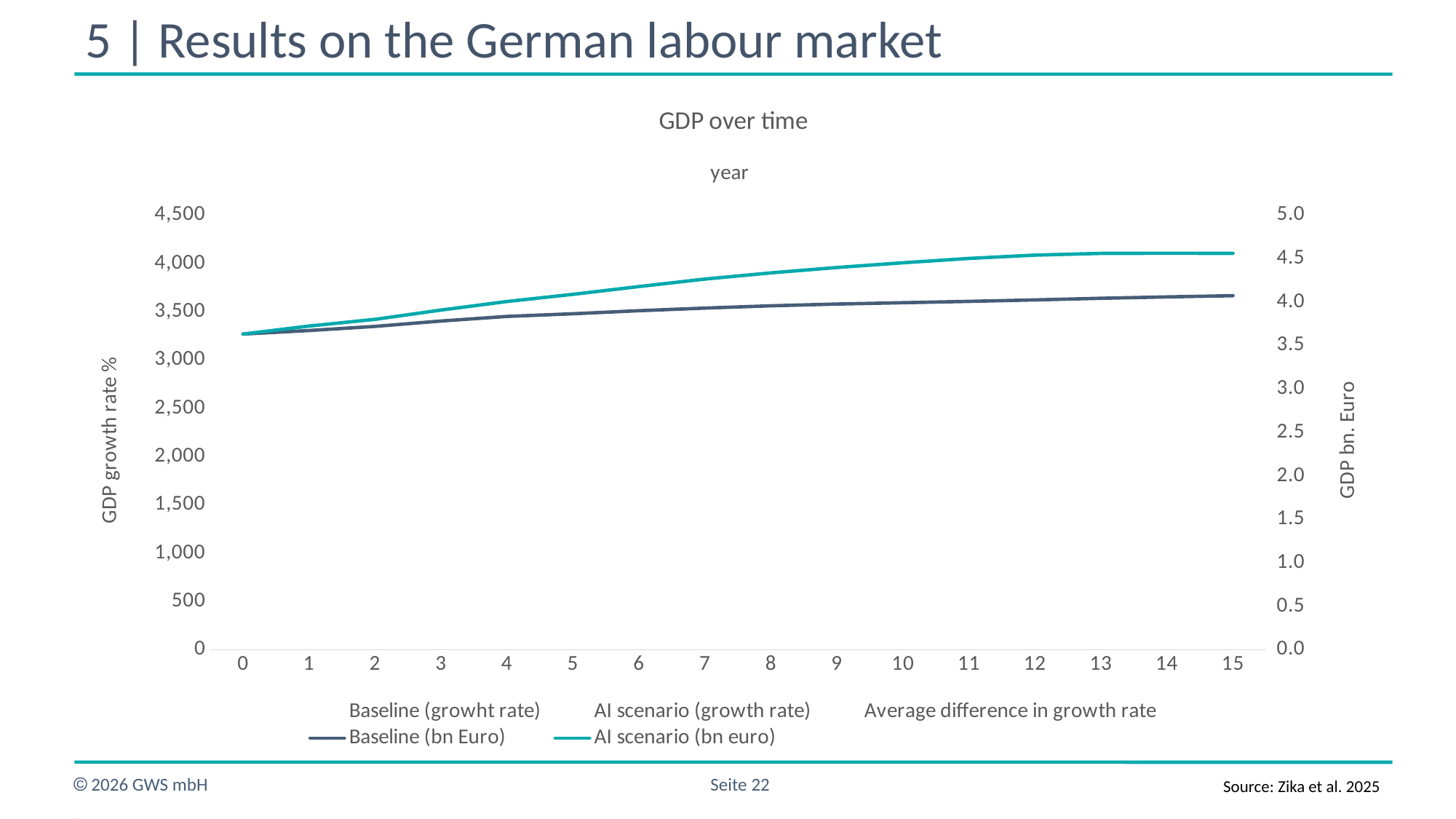
What is the label of the right-hand vertical axis? GDP bn. Euro Which plotted series reaches the highest value on the chart? AI scenario (bn euro) At year 15, which line is higher: Baseline (bn Euro) or AI scenario (bn euro)? AI scenario (bn euro) On the left axis, is the value of the AI scenario (bn euro) line at year 15 greater or less than 4,000? greater On the left axis, is the value of the Baseline (bn Euro) line at year 15 greater or less than 4,000? less How many entries does the chart's legend list? 5 How many year points are shown along the x axis? 16 What is the title of the chart? GDP over time Does the AI scenario (bn euro) line rise or fall from year 0 to year 15? rise Does the Baseline (bn Euro) line rise or fall from year 0 to year 15? rise How many lines are actually plotted on the chart? 2 What kind of chart is shown on the slide? line chart